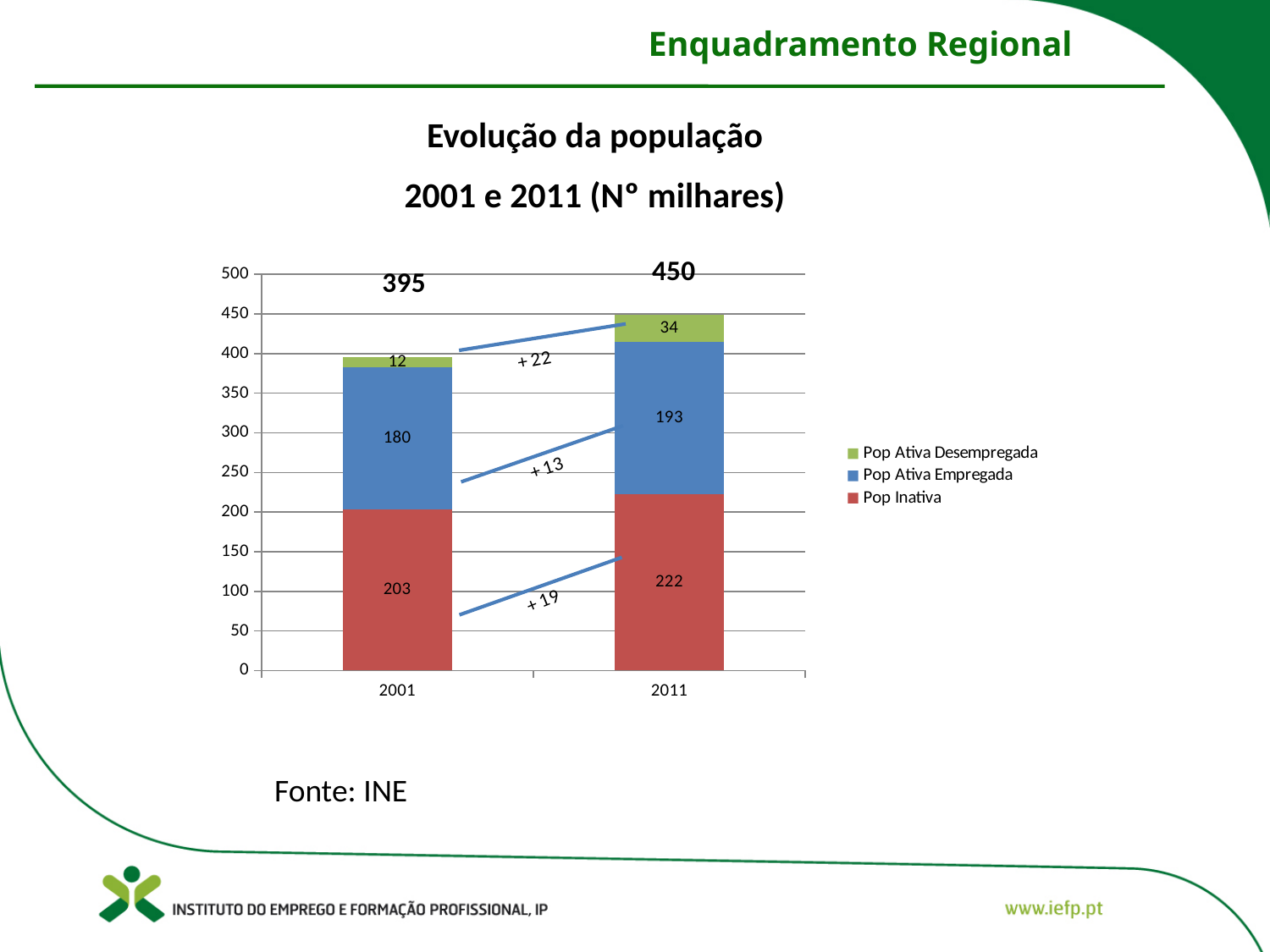
What is the value of Pop Ativa Empregada for 2011? 193 What is the total of the stacked bar for 2011? 450 Which colour represents Pop Inativa in the chart? Red What is the value of Pop Ativa Desempregada for 2011? 34 What is the total of the stacked bar for 2001? 395 What is the difference between Pop Ativa Desempregada in 2011 and in 2001? 22 What is the difference between Pop Inativa in 2011 and in 2001? 19 Which year has the larger value for Pop Ativa Empregada, 2001 or 2011? 2011 What kind of chart is shown on the slide? Stacked bar chart What is the value of Pop Inativa for 2001? 203 How many series does the legend list? 3 Which series has the lowest value in 2001? Pop Ativa Desempregada